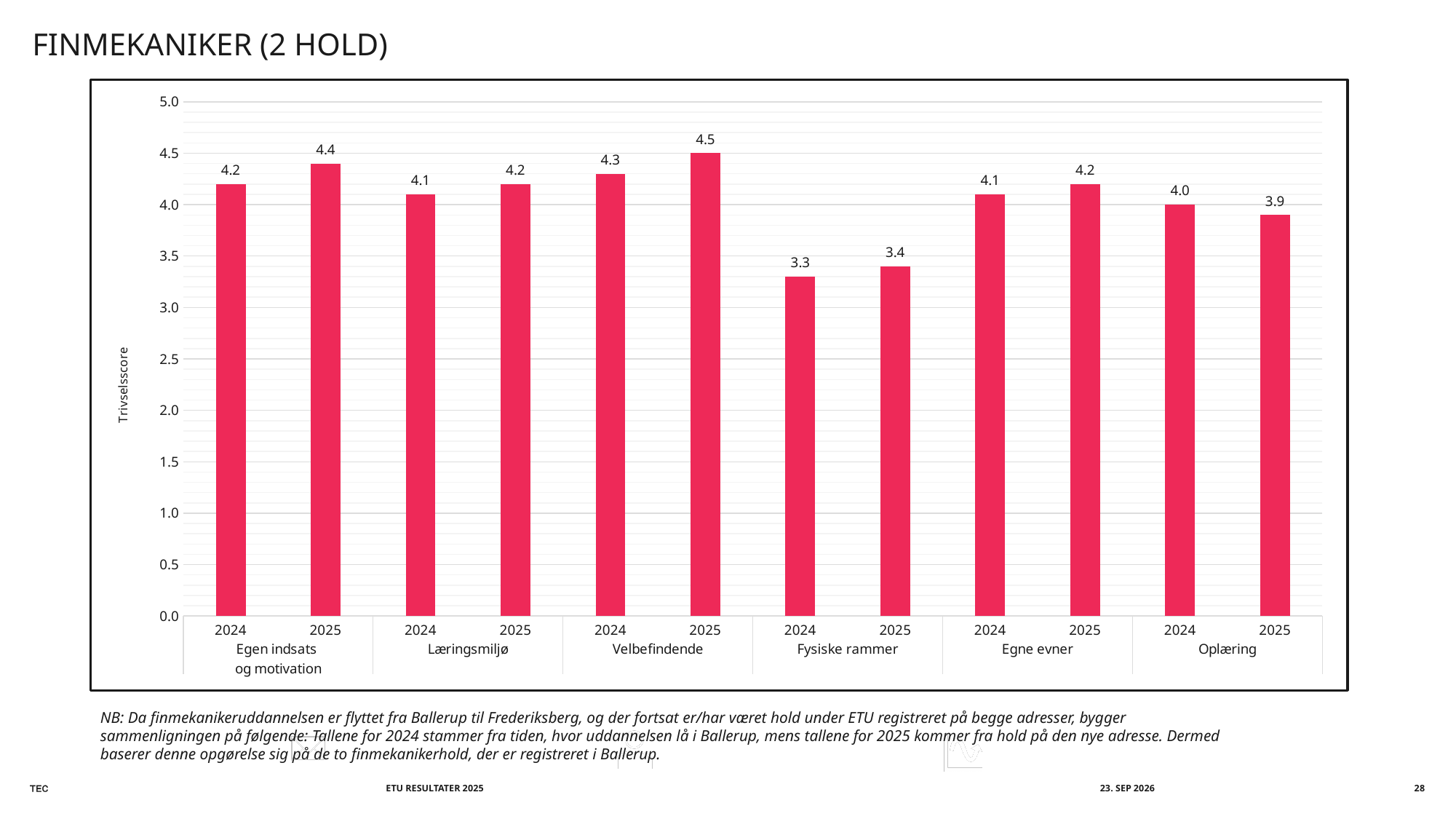
What is the difference between the 2025 and 2024 Trivselsscore for Velbefindende? 0.2 Which bar has the lowest Trivselsscore on the chart? Fysiske rammer 2024 What kind of chart is shown on the slide? Bar chart Which bar has the highest Trivselsscore on the chart? Velbefindende 2025 How many category groups are shown on the x axis? 6 Which is larger, the Oplæring score for 2024 or for 2025? 2024 What is the Trivselsscore for Velbefindende in 2025? 4.5 What is the Trivselsscore for Egen indsats og motivation in 2025? 4.4 What is the Trivselsscore for Oplæring in 2025? 3.9 What is the label on the y axis of the chart? Trivselsscore Is the Trivselsscore for Fysiske rammer in 2025 greater or less than 4.0? less What is the Trivselsscore for Fysiske rammer in 2024? 3.3